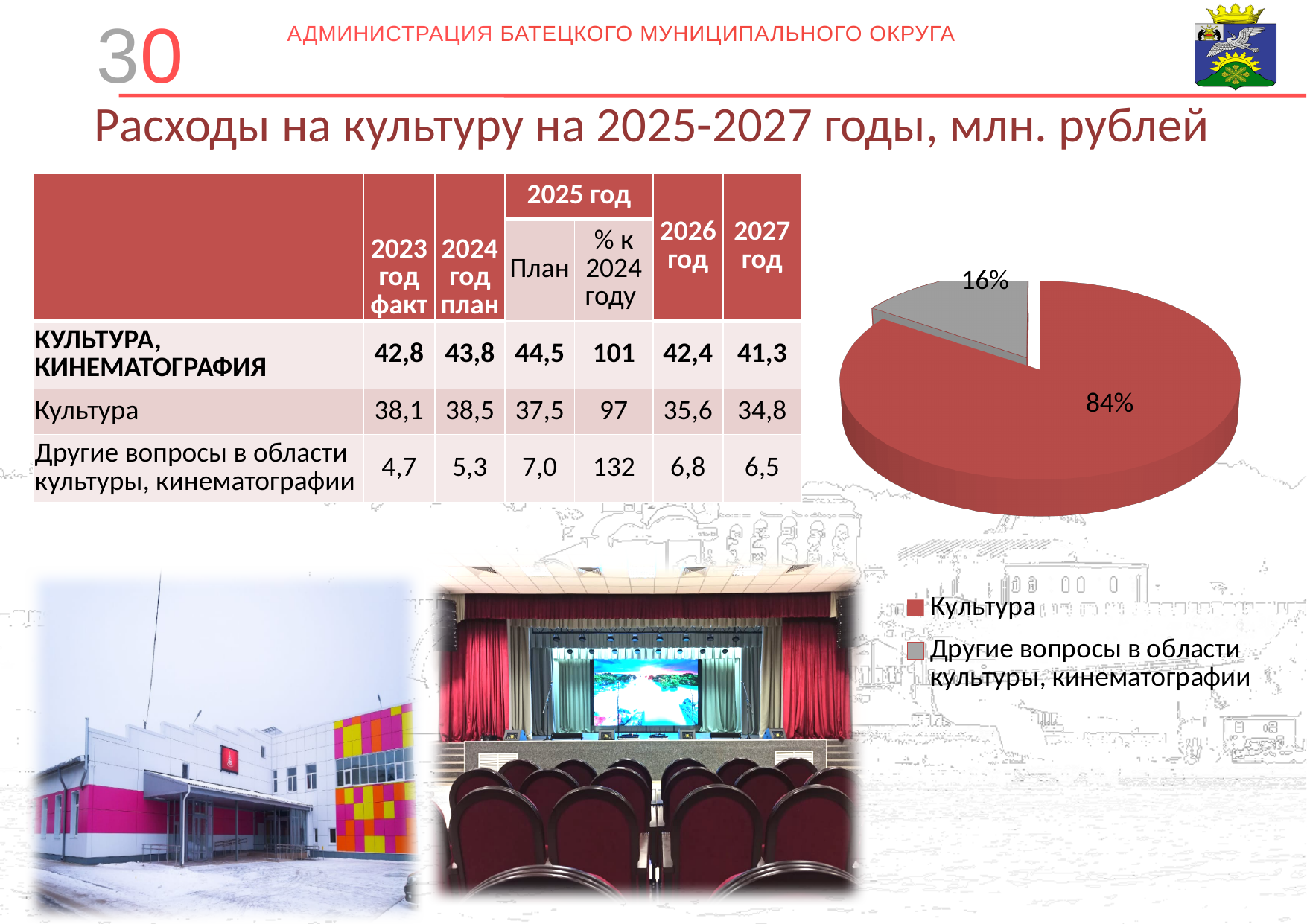
Which slice of the pie chart is the largest? Культура Which slice of the pie chart is the smallest? Другие вопросы в области культуры, кинематографии Which is larger in the pie chart: Культура or Другие вопросы в области культуры, кинематографии? Культура How many entries does the pie chart legend list? 2 What kind of chart is shown on the slide? pie chart What share of the pie chart does Другие вопросы в области культуры, кинематографии account for? 16% What share of the pie chart does Культура account for? 84% What colour is the Другие вопросы в области культуры, кинематографии slice in the pie chart? grey How many slices does the pie chart have? 2 What is the difference in percentage points between the Культура slice and the Другие вопросы в области культуры, кинематографии slice? 68 percentage points What colour is the Культура slice in the pie chart? red